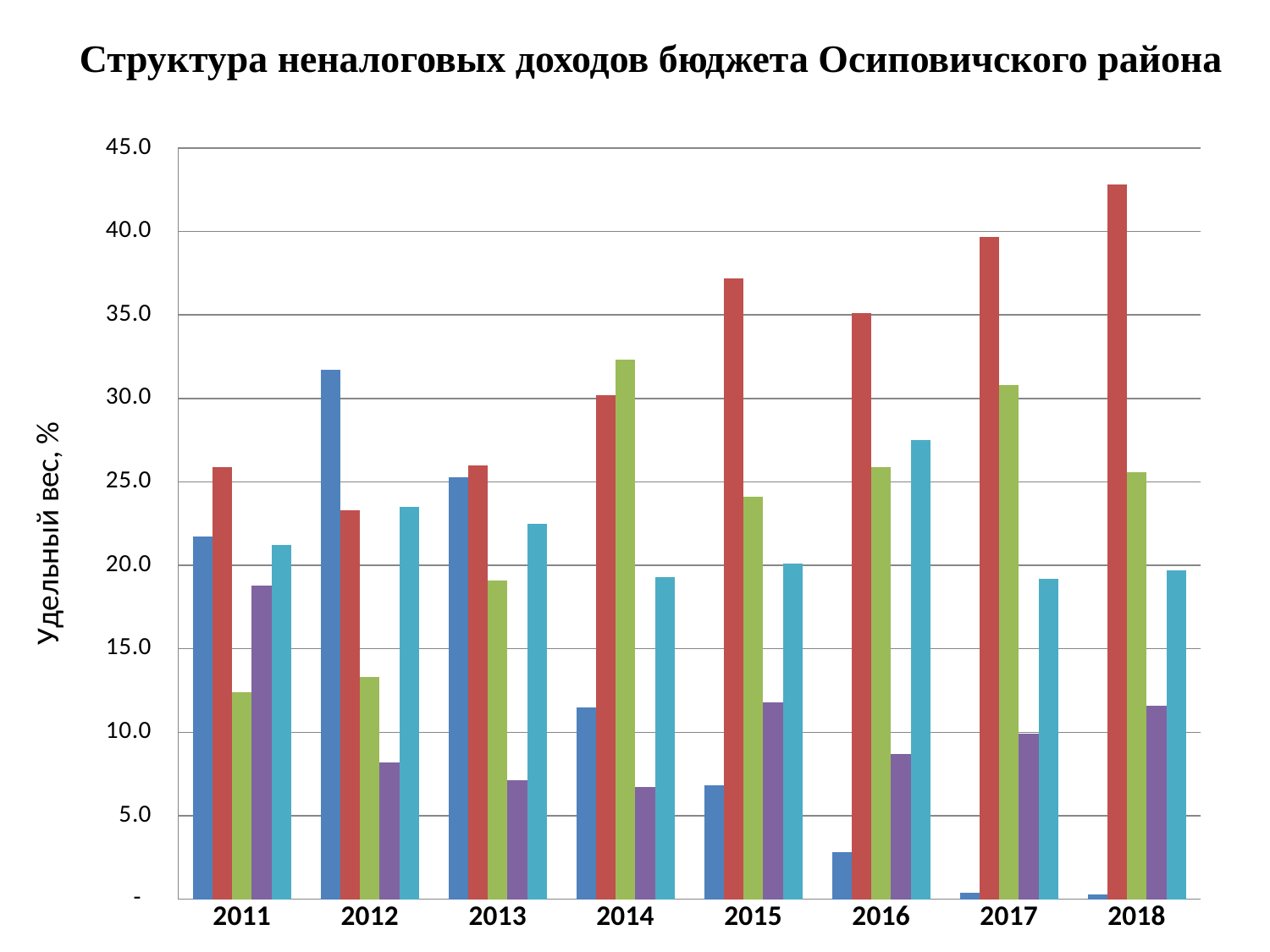
What is the title of the chart? Структура неналоговых доходов бюджета Осиповичского района Is the value of the green bar for 2011 greater or less than 15.0? less In which year is the red bar the tallest? 2018 Do the values of the red bars rise or fall from 2014 to 2018? rise How many years are shown along the x axis of the chart? 8 Is the value of the red bar for 2018 greater or less than 40.0? greater In 2016, which is larger: the red bar or the light blue bar? the red bar What kind of chart is shown on the slide? bar chart What is the label of the vertical axis? Удельный вес, % Is the value of the light blue bar for 2016 greater or less than 25.0? greater In which year is the blue bar the tallest? 2012